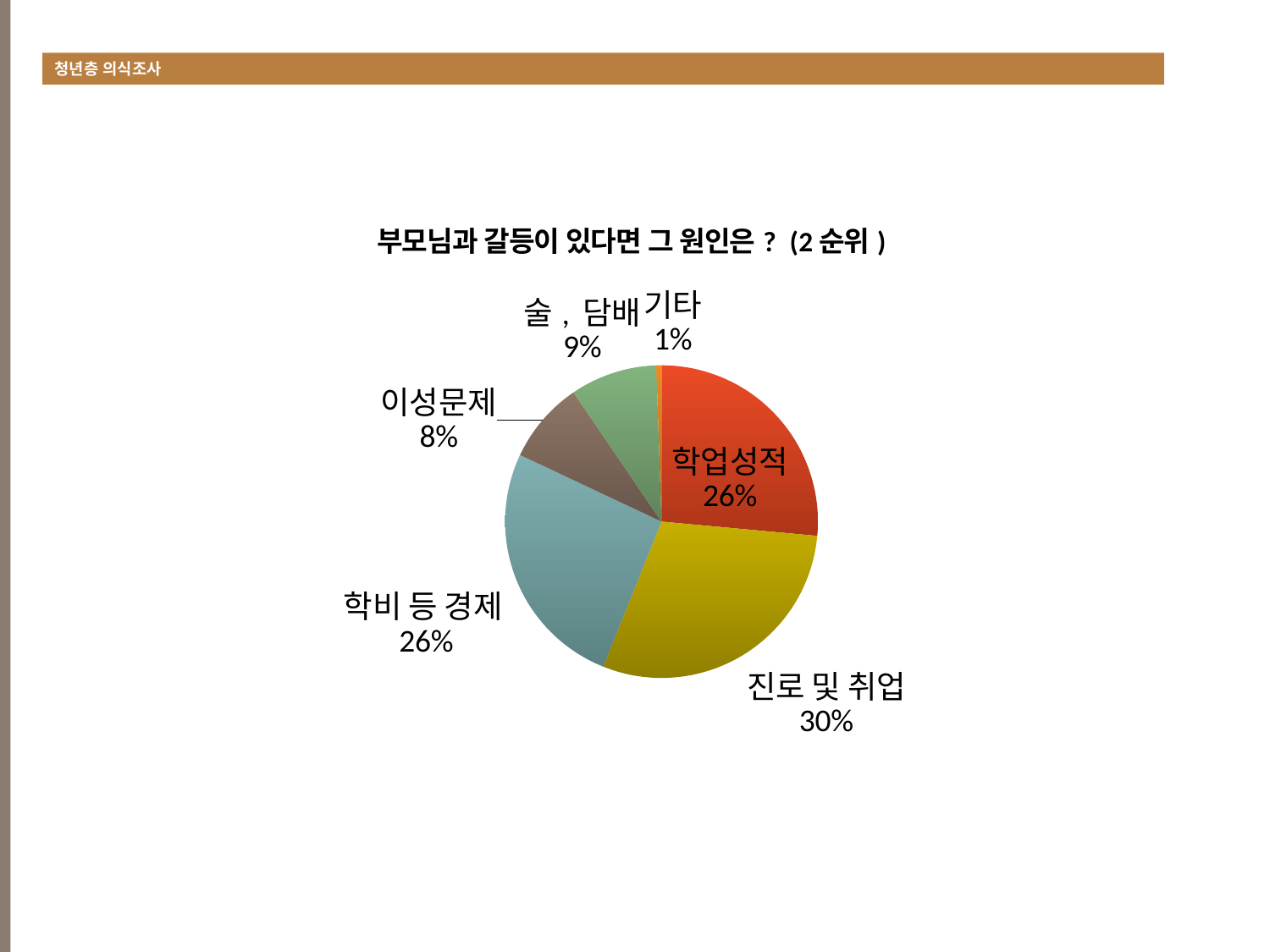
What share of the pie does 이성문제 represent? 8% Which category has the smallest share of the pie? 기타 What share of the pie does 기타 represent? 1% What share of the pie does 술, 담배 represent? 9% What is the title of the chart? 부모님과 갈등이 있다면 그 원인은 ? (2 순위 ) Which is larger, the share for 술, 담배 or the share for 이성문제? 술, 담배 What kind of chart is shown on the slide? Pie chart How many categories are shown in the pie chart? 6 Which category has the largest share of the pie? 진로 및 취업 What is the difference in percentage points between 진로 및 취업 and 학업성적? 4